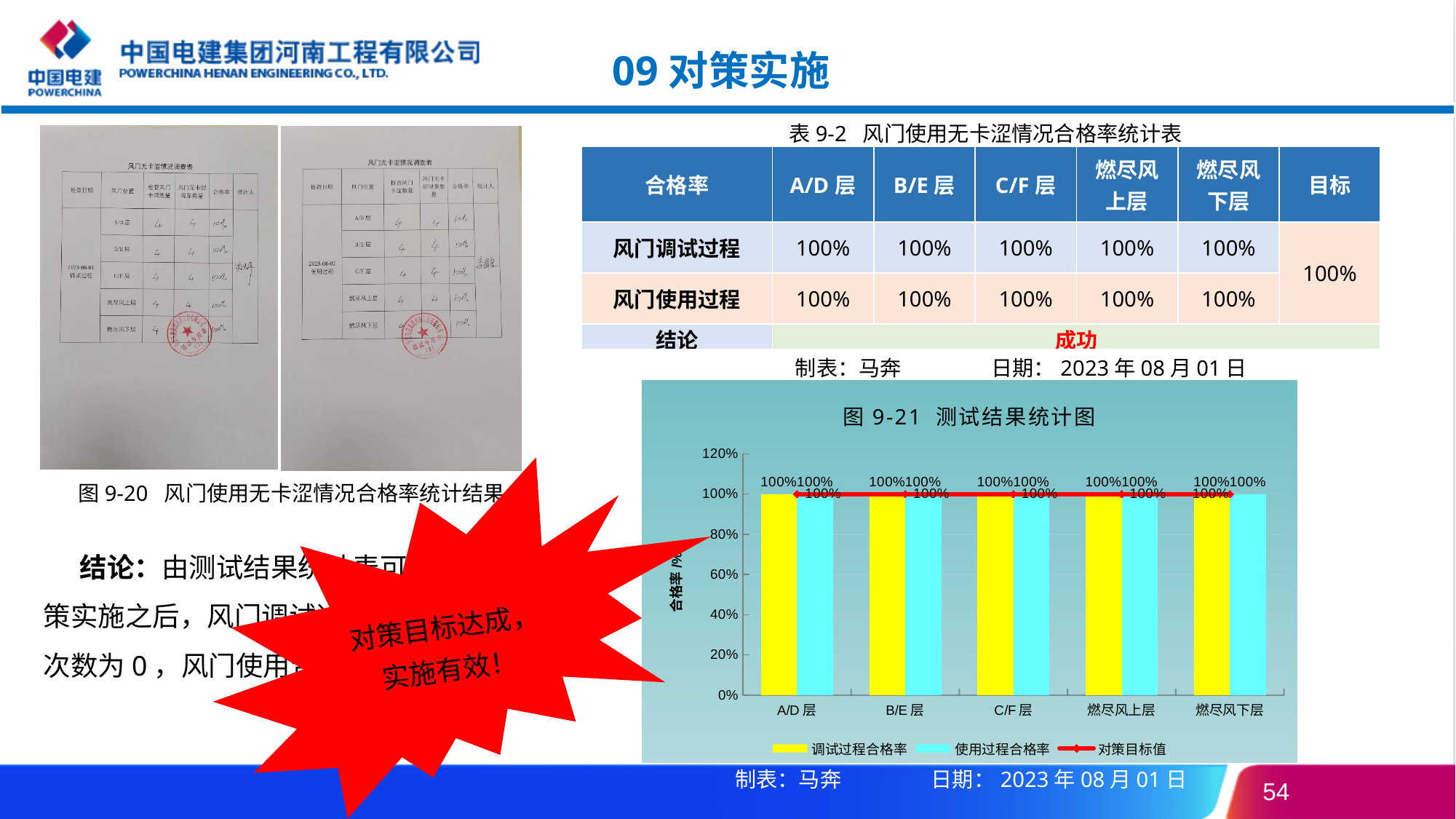
What is the value of 使用过程合格率 for B/E 层? 100% What kind of chart is 图 9-21? Bar chart with a line series What is the difference between 调试过程合格率 and 使用过程合格率 for 燃尽风上层? 0% How many categories are shown on the x axis of the chart? 5 Do the 调试过程合格率 values rise, fall, or stay flat across the categories? Stay flat Is the value of 使用过程合格率 for C/F 层 greater or less than 80%? greater What is the 对策目标值 shown for C/F 层? 100% How many series does the chart legend list? 3 What is the value of 调试过程合格率 for A/D 层? 100% Which colour represents 使用过程合格率 in the chart legend? Cyan (light blue) What is the value of 使用过程合格率 for 燃尽风下层? 100% What is the title of the chart? 图 9-21 测试结果统计图